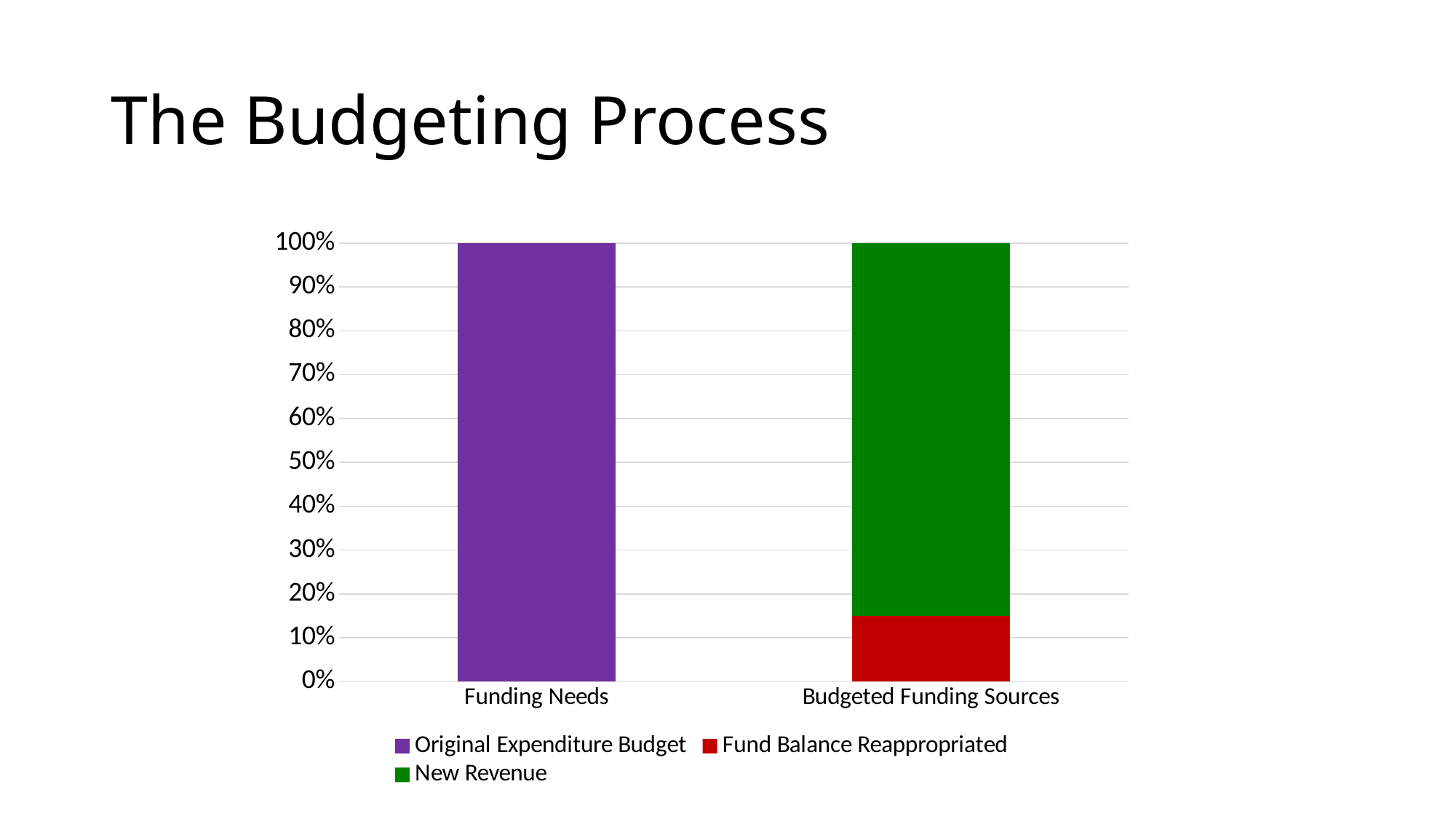
In the Budgeted Funding Sources bar, which is larger: New Revenue or Fund Balance Reappropriated? New Revenue How many categories are shown on the x axis of the chart? 2 What is the title of the slide containing the chart? The Budgeting Process What is the value of Original Expenditure Budget for Funding Needs? 100% What kind of chart is shown on the slide? Stacked bar chart How many series does the chart's legend list? 3 Is the New Revenue segment of the Budgeted Funding Sources bar greater or less than 80%? greater What colour represents New Revenue in the chart? Green Is the value for Fund Balance Reappropriated in Budgeted Funding Sources greater or less than 20%? less What is the total height of the Budgeted Funding Sources stacked bar? 100% Which series makes up the entire Funding Needs bar? Original Expenditure Budget Is the value for Fund Balance Reappropriated in Budgeted Funding Sources greater or less than 10%? greater